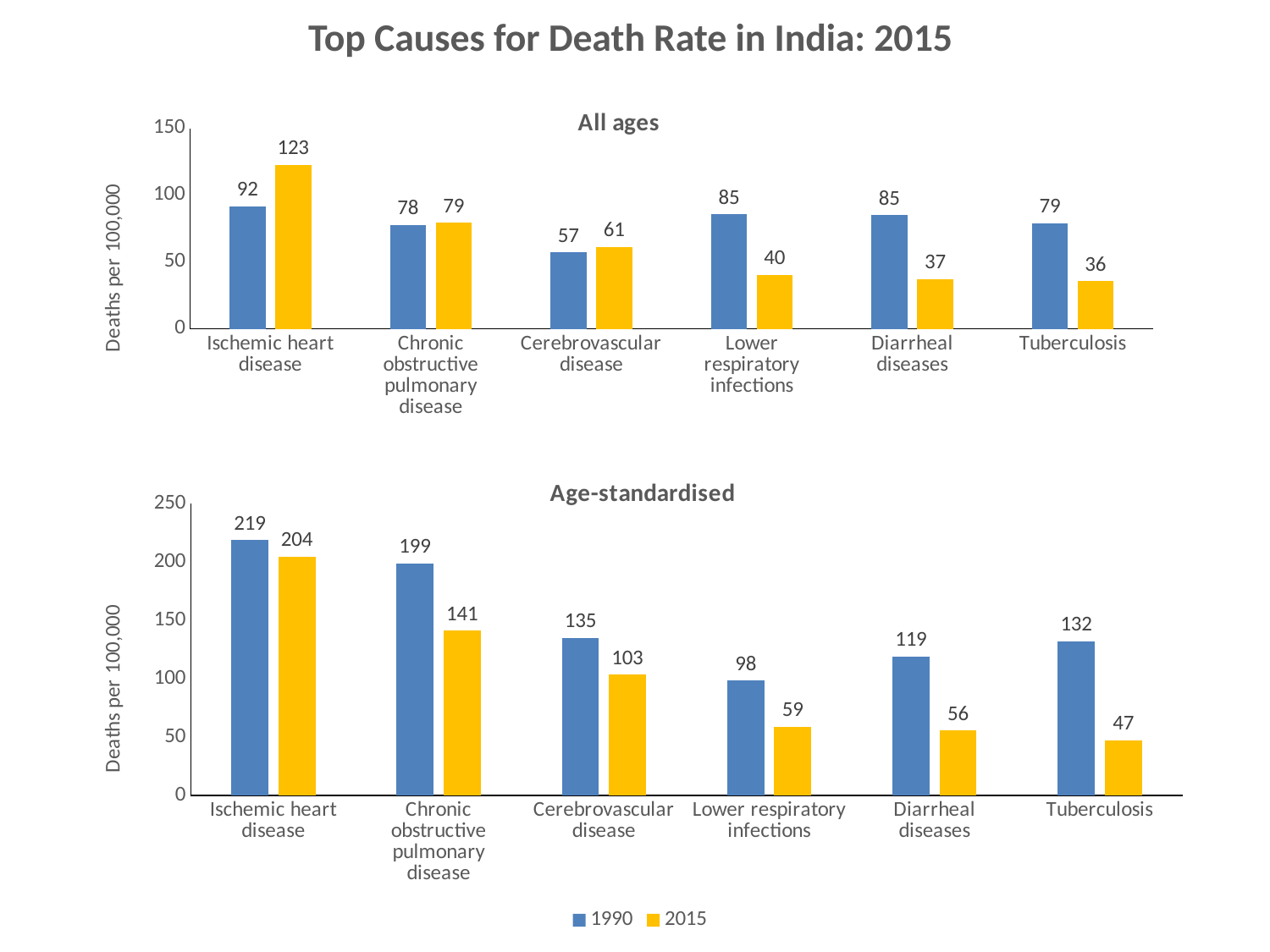
What kind of chart is the 'Age-standardised' chart? bar chart In the 'All ages' chart, what is the 1990 value for Lower respiratory infections? 85 In the 'Age-standardised' chart, what is the 2015 value for Tuberculosis? 47 In the 'Age-standardised' chart, which cause has the highest 1990 value? Ischemic heart disease How many series does the legend list? 2 In the 'Age-standardised' chart, is the 2015 value for Cerebrovascular disease greater or less than 150? less In the 'Age-standardised' chart, what is the difference between the 1990 and 2015 values for Chronic obstructive pulmonary disease? 58 In the 'All ages' chart, which is larger for Cerebrovascular disease: the 1990 value or the 2015 value? 2015 In the 'All ages' chart, what is the 2015 value for Ischemic heart disease? 123 In the 'All ages' chart, which cause has the lowest 2015 value? Tuberculosis How many causes of death are shown in the 'All ages' chart? 6 What is the title of the slide? Top Causes for Death Rate in India: 2015